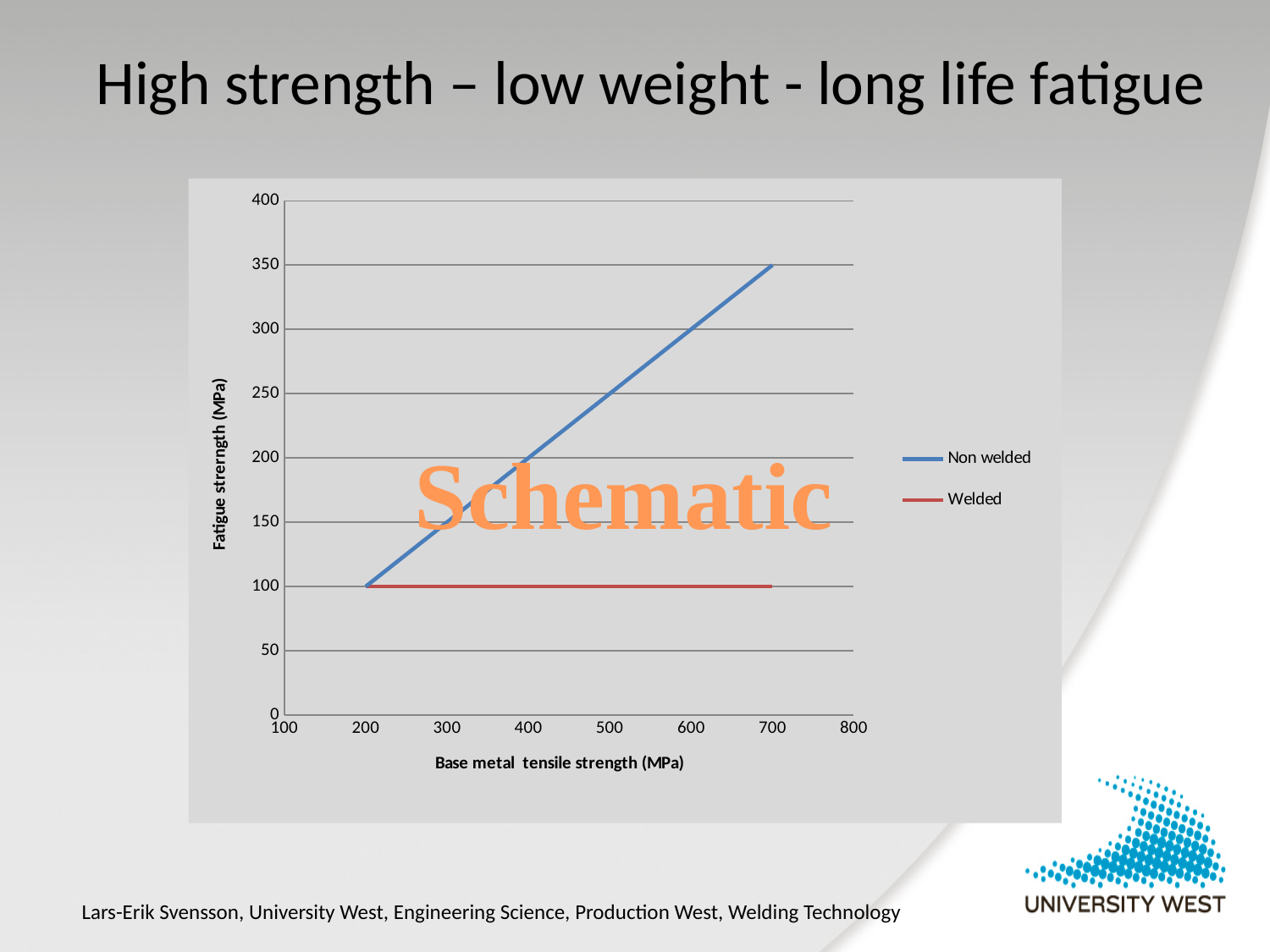
What is the fatigue strength of the Non welded series at a base metal tensile strength of 700 MPa? 350 Does the Non welded line rise or fall as base metal tensile strength increases? rise At a base metal tensile strength of 600 MPa, which series has the higher fatigue strength? Non welded Does the Welded line rise, fall or stay flat as base metal tensile strength increases? stay flat What is the title of the x axis? Base metal tensile strength (MPa) What is the fatigue strength of the Non welded series at a base metal tensile strength of 200 MPa? 100 What is the fatigue strength of the Welded series at a base metal tensile strength of 500 MPa? 100 Is the Non welded fatigue strength at 500 MPa base metal tensile strength greater or less than 200? greater What are the two series named in the legend? Non welded and Welded At a base metal tensile strength of 700 MPa, what is the difference in fatigue strength between the Non welded and Welded series? 250 What kind of chart is shown on the slide? line chart How many series does the legend list? 2